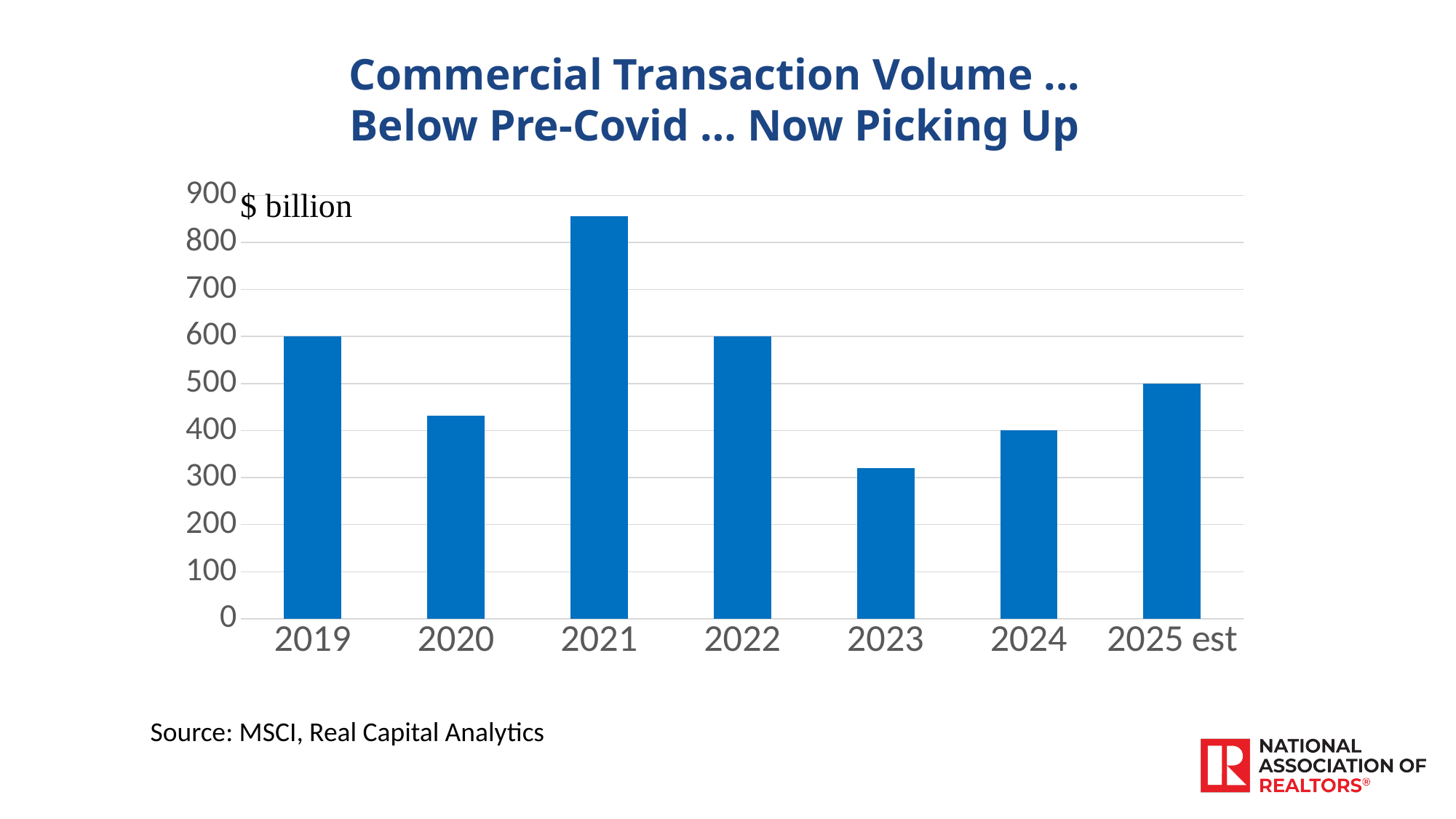
Which year has the highest commercial transaction volume? 2021 Which year has the lowest commercial transaction volume? 2023 What source is cited for the chart? MSCI, Real Capital Analytics Is the value for 2021 greater or less than 800? greater Which is larger, the value for 2022 or the value for 2024? 2022 What kind of chart is shown on the slide? bar chart Do the values rise or fall from 2023 to 2025 est? rise Is the value for 2023 greater or less than 400? less How many years (categories) are shown on the x axis? 7 What unit is the y axis measured in, according to the label on the chart? $ billion Is the value for 2020 greater or less than 500? less Which is larger, the value for 2020 or the value for 2023? 2020